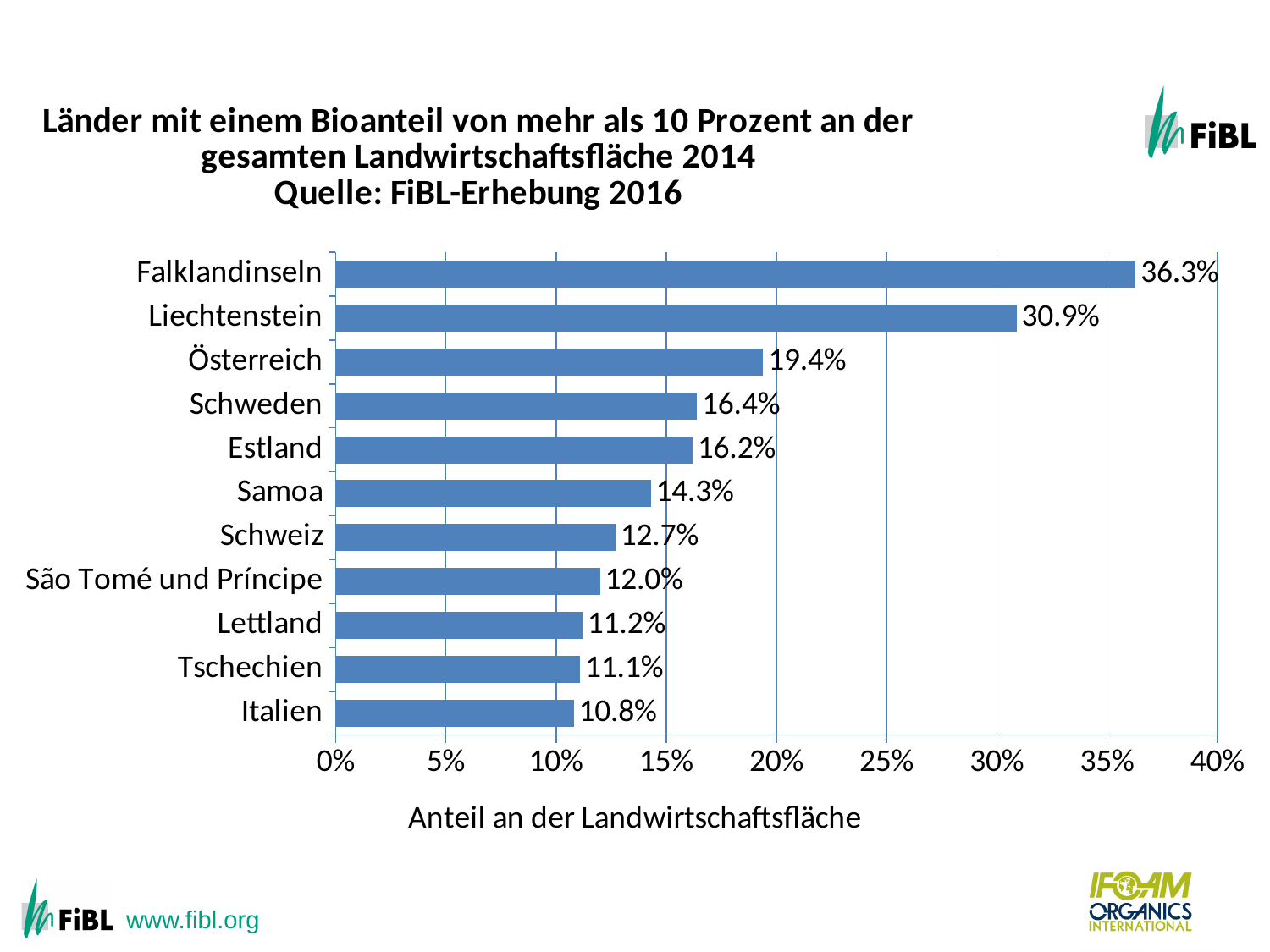
What is the organic share of agricultural land for Liechtenstein? 30.9% Which country has the lowest value on the chart? Italien What is the value for São Tomé und Príncipe? 12.0% What kind of chart is shown on the slide? bar chart What is the difference between the values for Falklandinseln and Liechtenstein? 5.4% Is the value for Österreich greater or less than 20%? less How many countries are shown on the chart? 11 What is the difference between the values for Österreich and Schweiz? 6.7% What value is shown for Samoa? 14.3% Which has a larger value, Schweden or Estland? Schweden What is the label of the horizontal axis? Anteil an der Landwirtschaftsfläche Which country has the highest organic share of agricultural land? Falklandinseln